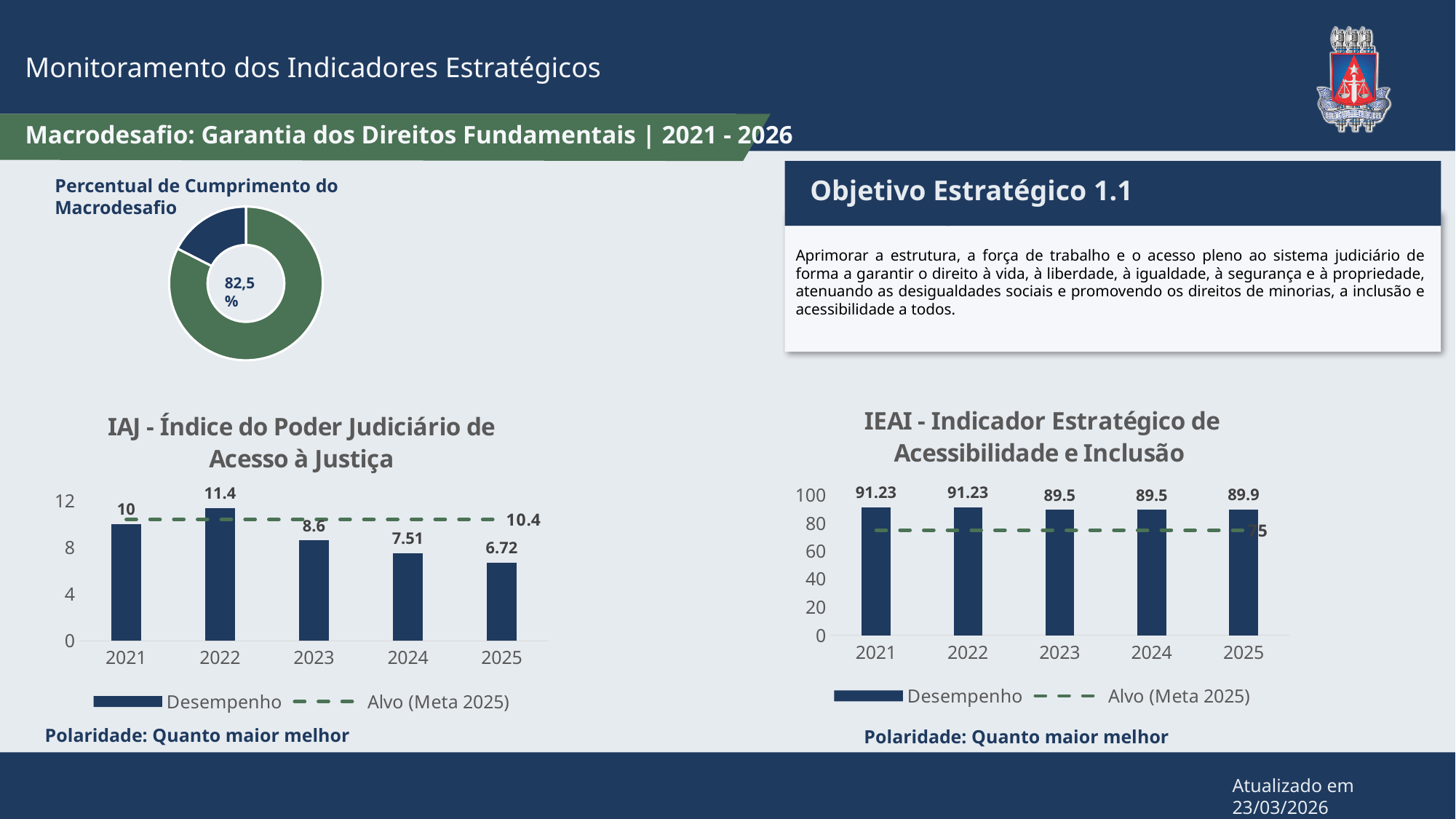
In the IAJ - Índice do Poder Judiciário de Acesso à Justiça chart, do the Desempenho values rise or fall from 2022 to 2025? fall In the IAJ - Índice do Poder Judiciário de Acesso à Justiça chart, which year has the lowest Desempenho value? 2025 In the IEAI - Indicador Estratégico de Acessibilidade e Inclusão chart, is the Desempenho value for 2025 larger or smaller than the value for 2024? larger In the IEAI - Indicador Estratégico de Acessibilidade e Inclusão chart, what is the Desempenho value for 2023? 89.5 In the IEAI - Indicador Estratégico de Acessibilidade e Inclusão chart, how many years are shown on the x axis? 5 What percentage is shown in the centre of the Percentual de Cumprimento do Macrodesafio donut chart? 82,5% In the IAJ - Índice do Poder Judiciário de Acesso à Justiça chart, what is the difference between the Desempenho values for 2022 and 2023? 2.8 In the IEAI - Indicador Estratégico de Acessibilidade e Inclusão chart, what is the Desempenho value for 2021? 91.23 In the IAJ - Índice do Poder Judiciário de Acesso à Justiça chart, what is the Desempenho value for 2022? 11.4 In the IAJ - Índice do Poder Judiciário de Acesso à Justiça chart, which year has the highest Desempenho value? 2022 In the IAJ - Índice do Poder Judiciário de Acesso à Justiça chart, what is the Desempenho value for 2025? 6.72 In the IAJ - Índice do Poder Judiciário de Acesso à Justiça chart, what is the value of the Alvo (Meta 2025) line? 10.4